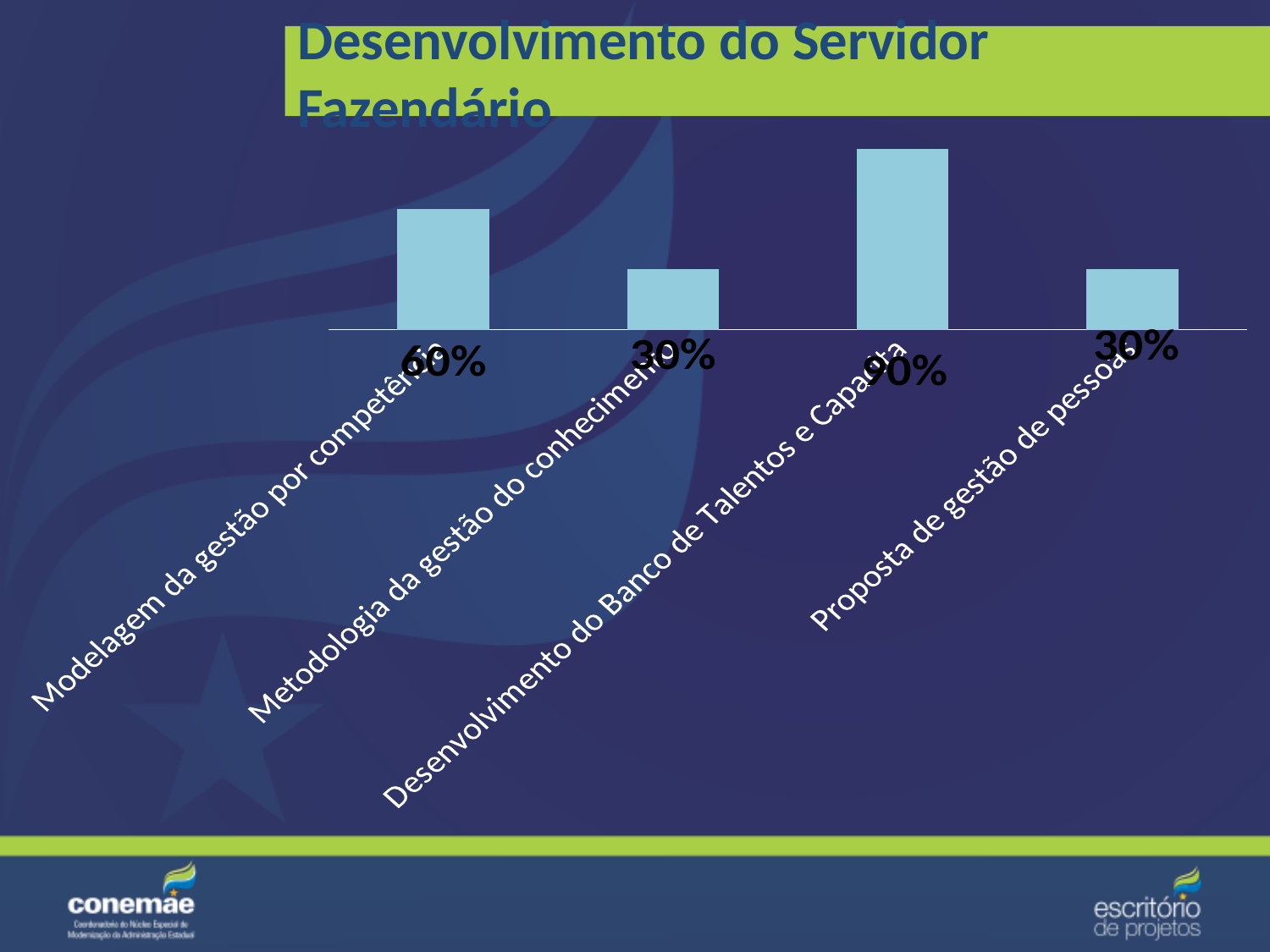
What is the value for Desenvolvimento do Banco de Talentos? 90% What is the difference between the values for Modelagem da gestão por competências and Metodologia da gestão do conhecimento? 30% What is the value for Modelagem da gestão por competências? 60% Which category has the highest value? Desenvolvimento do Banco de Talentos How many categories have a value of 30%? 2 What is the difference between the values for Desenvolvimento do Banco de Talentos and Modelagem da gestão por competências? 30% What kind of chart is shown on the slide? Bar chart How many categories are shown in the chart? 4 What is the title of the slide? Desenvolvimento do Servidor Fazendário What is the value for Proposta de gestão de pessoas? 30% What is the value for Metodologia da gestão do conhecimento? 30% Which is larger, the value for Modelagem da gestão por competências or the value for Proposta de gestão de pessoas? Modelagem da gestão por competências